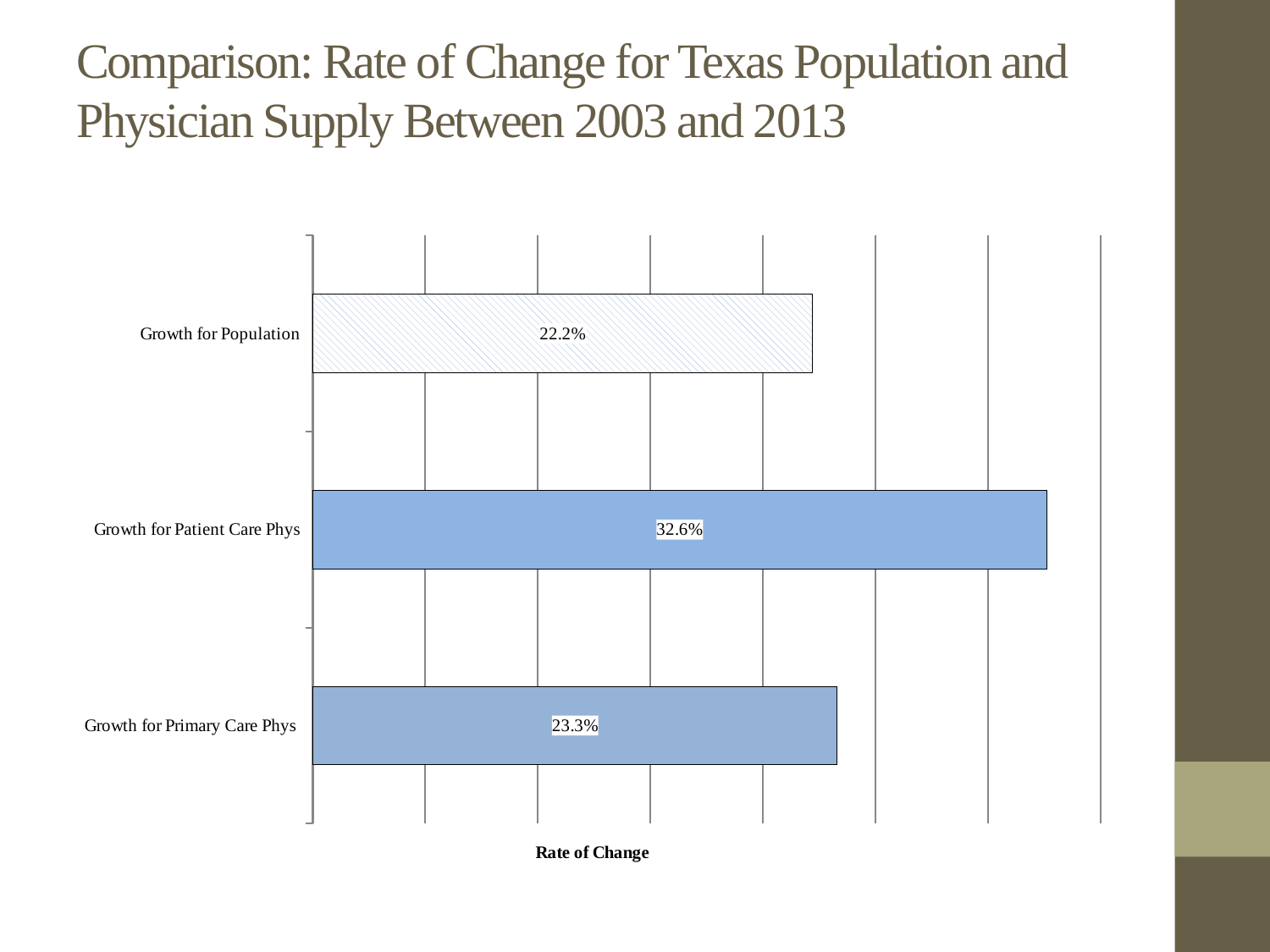
What is the difference between the values for Growth for Patient Care Phys and Growth for Primary Care Phys? 9.3 percentage points What is the value for Growth for Primary Care Phys? 23.3% What is the difference between the values for Growth for Patient Care Phys and Growth for Population? 10.4 percentage points Which category has the lowest rate of change? Growth for Population What is the value for Growth for Population? 22.2% Which is larger, the value for Growth for Primary Care Phys or the value for Growth for Population? Growth for Primary Care Phys Which category has the highest rate of change? Growth for Patient Care Phys Which bar is drawn with a hatched pattern rather than a solid fill? Growth for Population What is the value for Growth for Patient Care Phys? 32.6% How many categories are shown in the chart? 3 What is the title of the horizontal axis? Rate of Change What kind of chart is shown on the slide? Bar chart